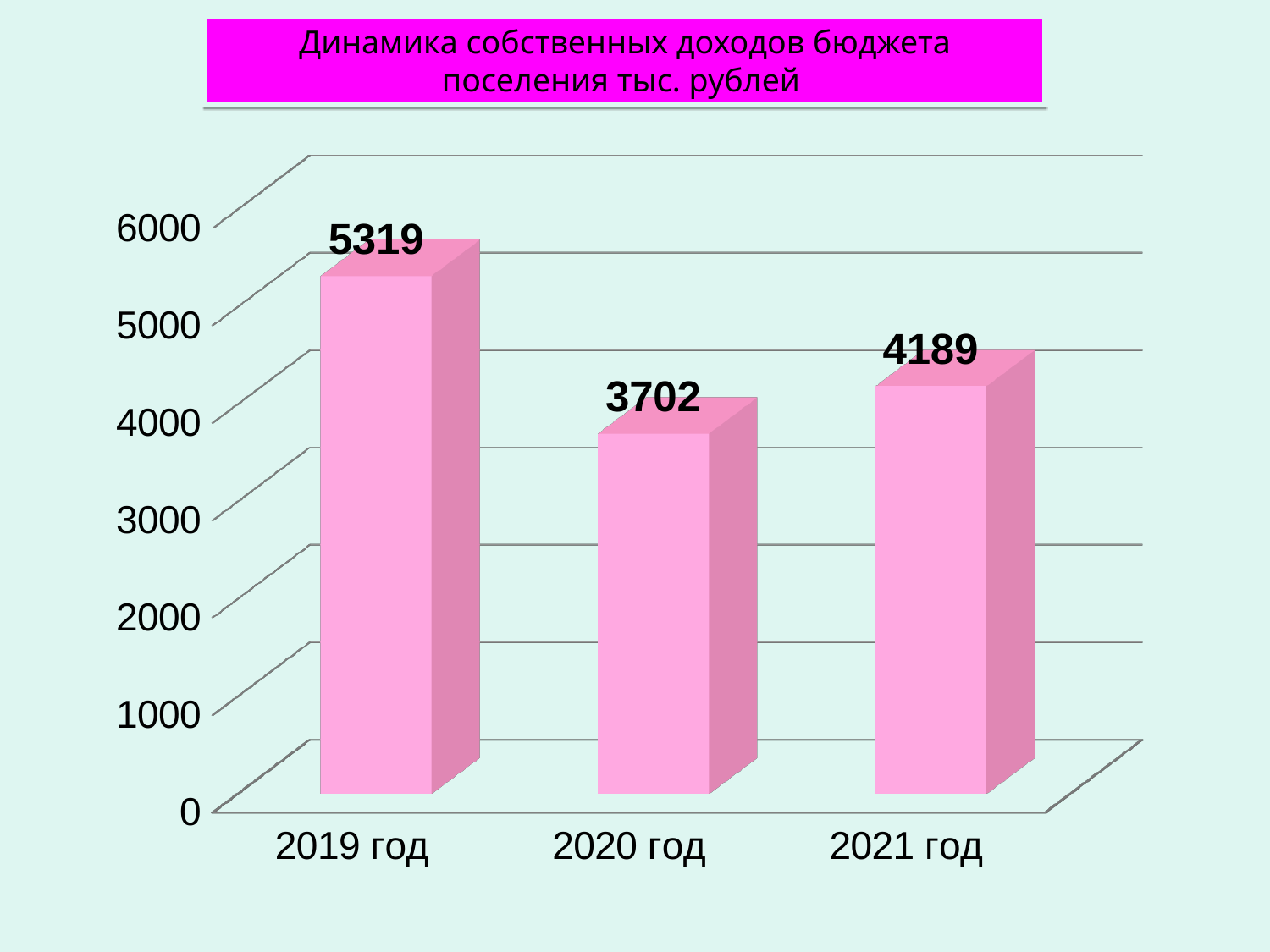
Which year has the highest value? 2019 год What is the title of the chart? Динамика собственных доходов бюджета поселения тыс. рублей What is the value for 2021 год? 4189 What is the difference between the values for 2021 год and 2020 год? 487 What is the difference between the values for 2019 год and 2020 год? 1617 How many years are shown on the chart? 3 What is the value for 2019 год? 5319 Is the value for 2021 год greater or less than 5000? less Which year has the lowest value? 2020 год Which is larger, the value for 2020 год or 2021 год? 2021 год What kind of chart is shown on the slide? bar chart What is the value for 2020 год? 3702